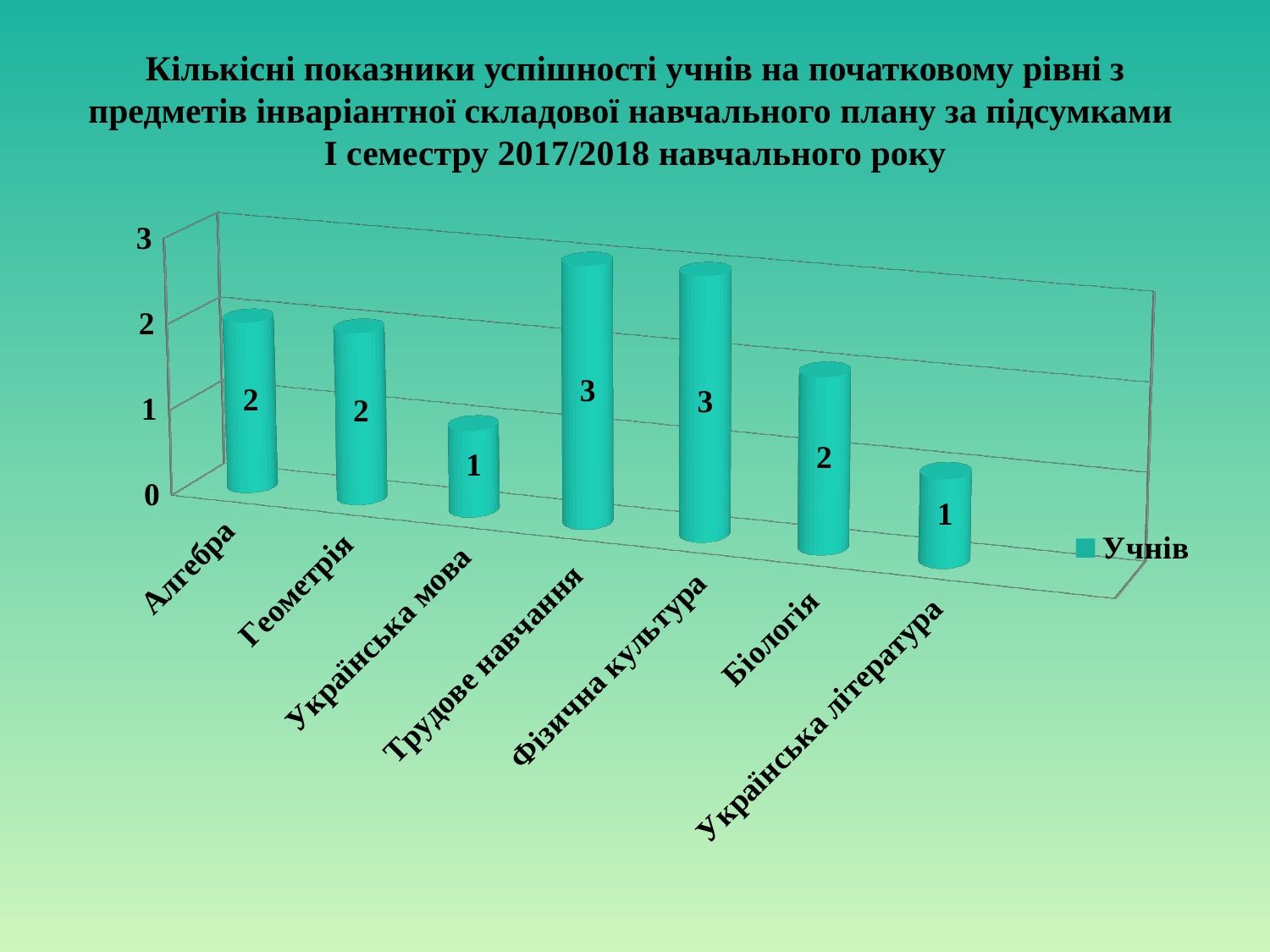
How many categories are shown on the x axis? 7 What is the value for Українська література? 1 What is the value for Трудове навчання? 3 What is the value for Алгебра? 2 Which is larger, the value for Алгебра or the value for Українська мова? Алгебра What is the difference between the values for Геометрія and Українська література? 1 What kind of chart is shown on the slide? Bar chart What is the value for Фізична культура? 3 What is the value for Біологія? 2 How many series does the legend list? 1 What is the difference between the values for Трудове навчання and Українська мова? 2 Which is larger, the value for Фізична культура or the value for Біологія? Фізична культура